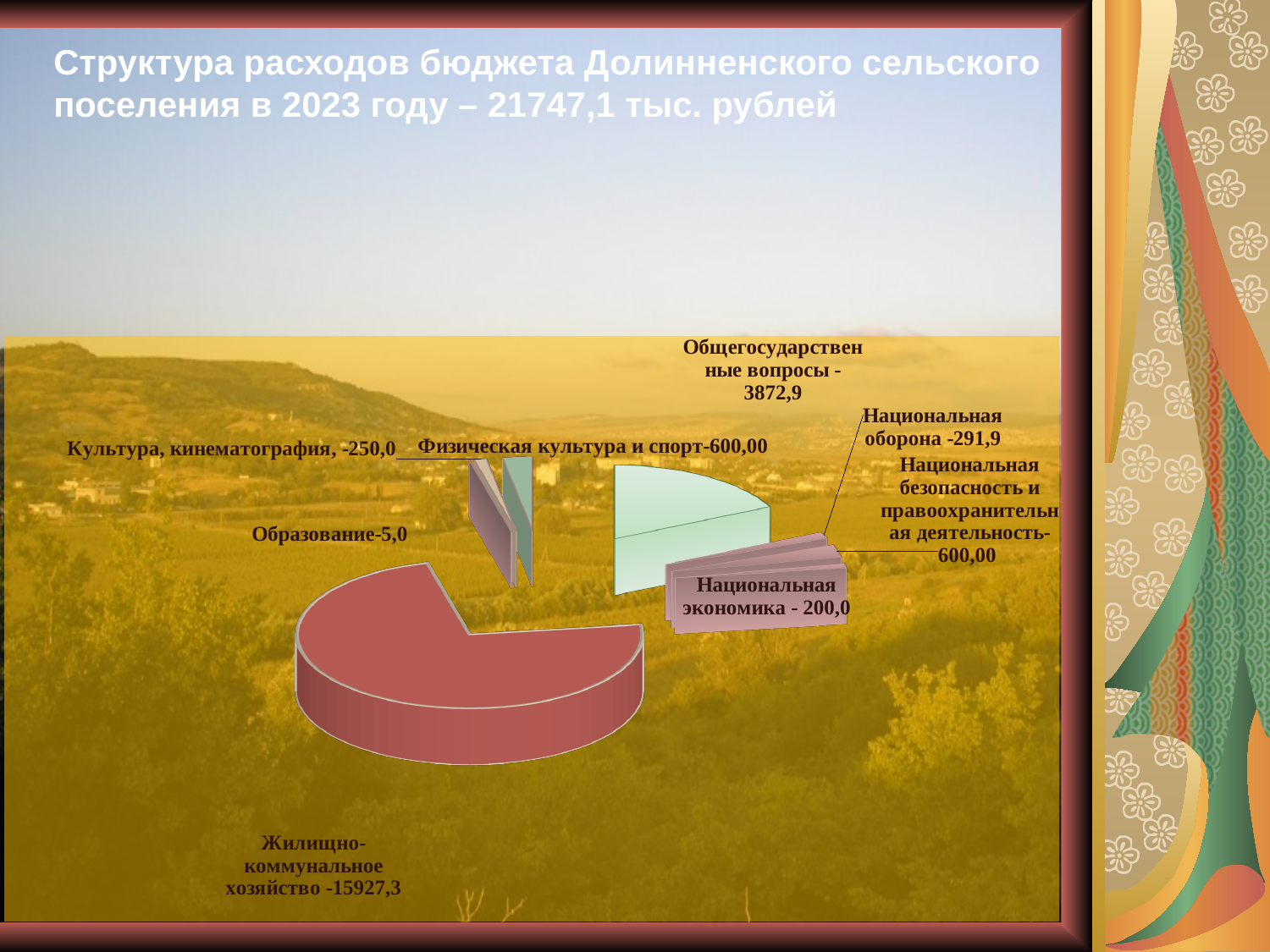
What type of chart is shown on the slide? pie chart What is the value for Общегосударственные вопросы? 3872,9 What is the value for Образование? 5,0 What is the value for Национальная экономика? 200,0 How many categories are shown in the pie chart? 8 What total budget expenditure amount is stated in the slide title for 2023? 21747,1 тыс. рублей What is the value for Жилищно-коммунальное хозяйство? 15927,3 Which is larger: Национальная оборона or Культура, кинематография? Национальная оборона Which category has the smallest value? Образование What is the difference between Общегосударственные вопросы and Национальная оборона? 3581,0 What is the value for Национальная оборона? 291,9 Which category has the largest share of the pie? Жилищно-коммунальное хозяйство